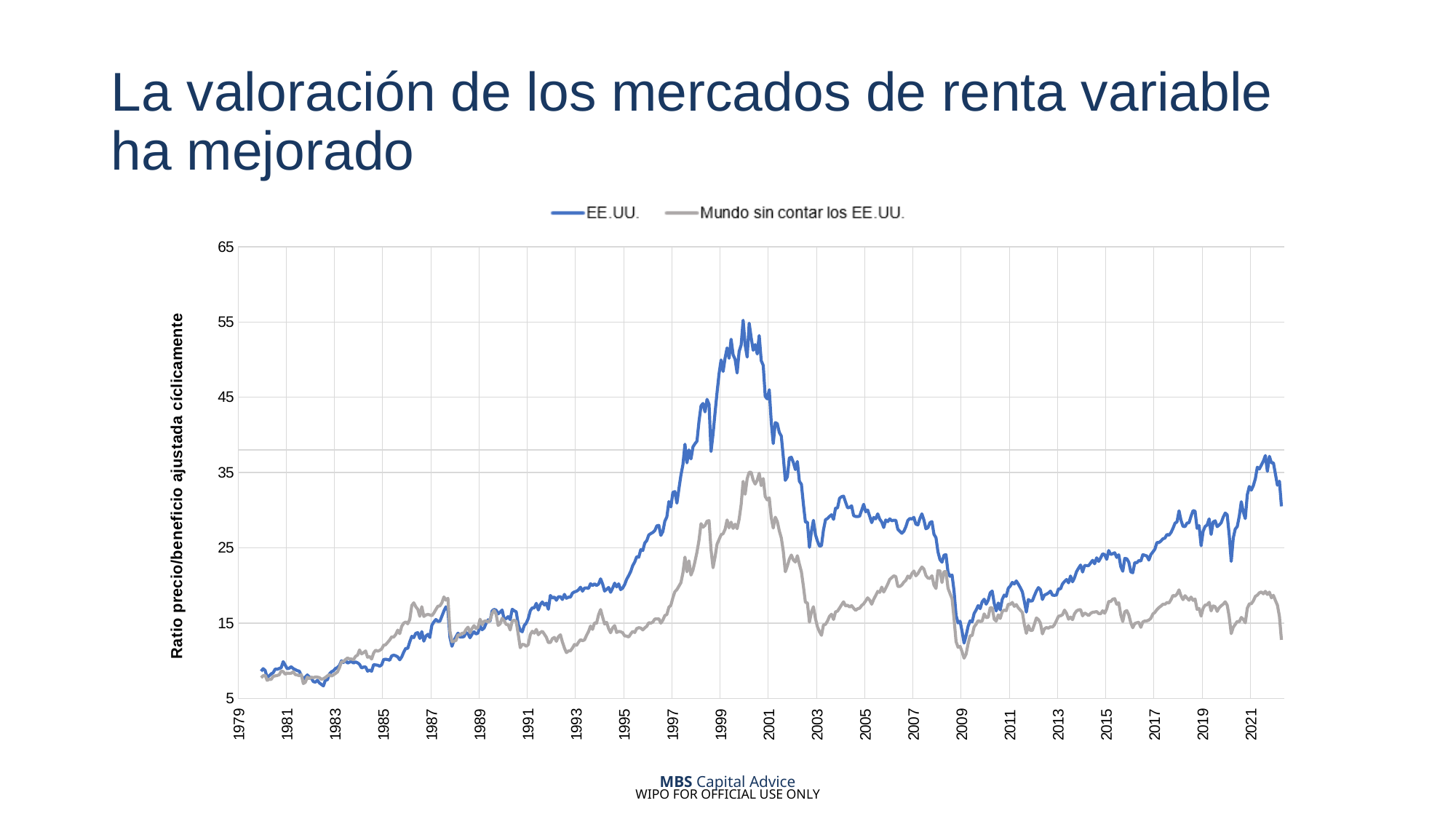
Is the peak value of the EE.UU. series around 2021 greater or less than 25? greater Is the peak value of the Mundo sin contar los EE.UU. series around 2021 greater or less than 25? less How many series does the legend list? 2 What is the label of the vertical axis? Ratio precio/beneficio ajustada cíclicamente Is the peak value of the EE.UU. series around the year 2000 greater or less than 45? greater Does the EE.UU. series rise or fall between 1995 and 2000? rise Does the EE.UU. series rise or fall between 2000 and 2003? fall Around 2021, which series is higher, EE.UU. or Mundo sin contar los EE.UU.? EE.UU. What kind of chart is shown on the slide? line chart What are the two series named in the legend? EE.UU. and Mundo sin contar los EE.UU. Which series reaches the highest value anywhere on the chart? EE.UU.